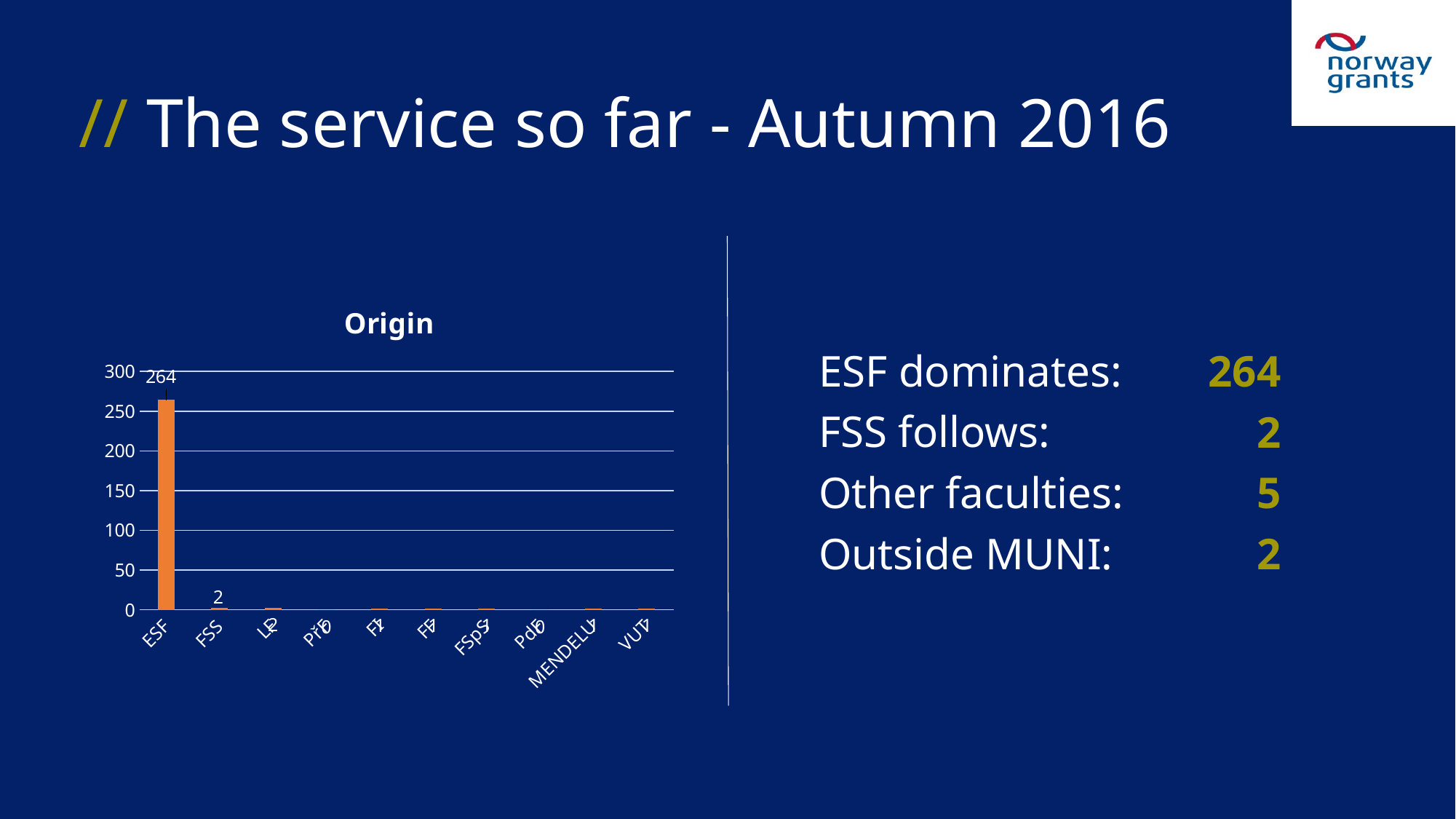
What is the value for FSS in the Origin chart? 2 Which category has the highest value in the Origin chart? ESF What colour are the bars in the Origin chart? orange What kind of chart is the Origin chart? bar chart Is the value for ESF in the Origin chart greater or less than 250? greater What is the highest value shown on the y axis of the Origin chart? 300 What is the value for ESF in the Origin chart? 264 Is the value for FSS in the Origin chart greater or less than 50? less What is the title of the chart on the slide? Origin What is the difference between the values for ESF and FSS in the Origin chart? 262 Which is larger in the Origin chart, the value for ESF or the value for FSS? ESF How many categories are shown on the x axis of the Origin chart? 10